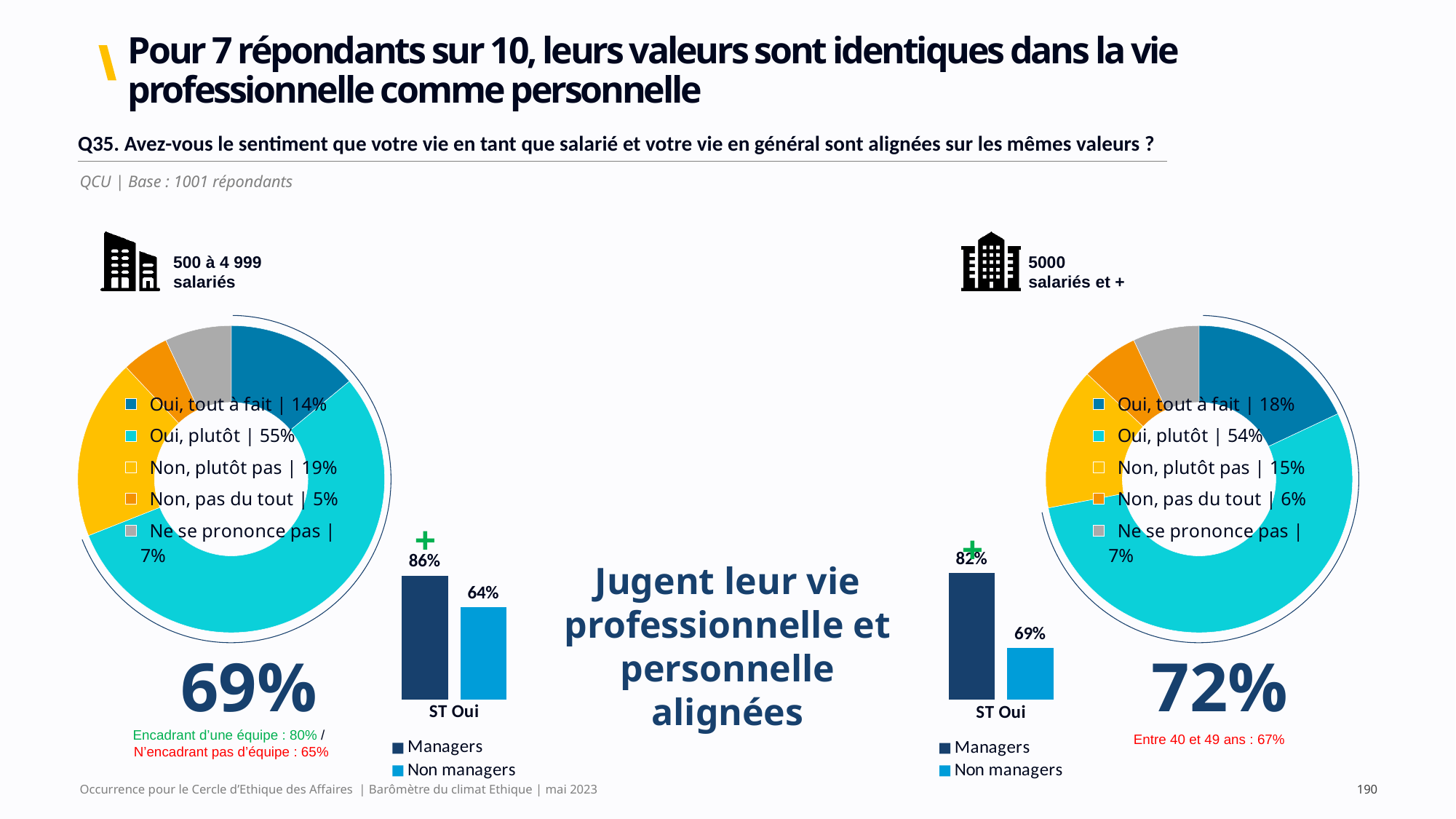
In the 'ST Oui' bar chart for '500 à 4 999 salariés', which is larger, Managers or Non managers? Managers What kind of chart is the 'ST Oui' chart for '5000 salariés et +'? Bar chart In the 'ST Oui' bar chart for '5000 salariés et +', what is the difference between Managers and Non managers? 13 percentage points In the 'ST Oui' bar chart for '5000 salariés et +', what is the value for Non managers? 69% In the donut chart for '5000 salariés et +', which category has the smallest share? Non, pas du tout In the 'ST Oui' bar chart for '500 à 4 999 salariés', what is the value for Managers? 86% In the donut chart for '500 à 4 999 salariés', what share is 'Oui, plutôt'? 55% In the donut chart for '500 à 4 999 salariés', which category has the largest share? Oui, plutôt In the donut chart for '500 à 4 999 salariés', what is the difference between 'Non, plutôt pas' and 'Non, pas du tout'? 14 percentage points How many categories does the donut chart for '5000 salariés et +' show? 5 How many series does the legend of the 'ST Oui' bar chart for '500 à 4 999 salariés' list? 2 In the donut chart for '5000 salariés et +', what share is 'Oui, tout à fait'? 18%